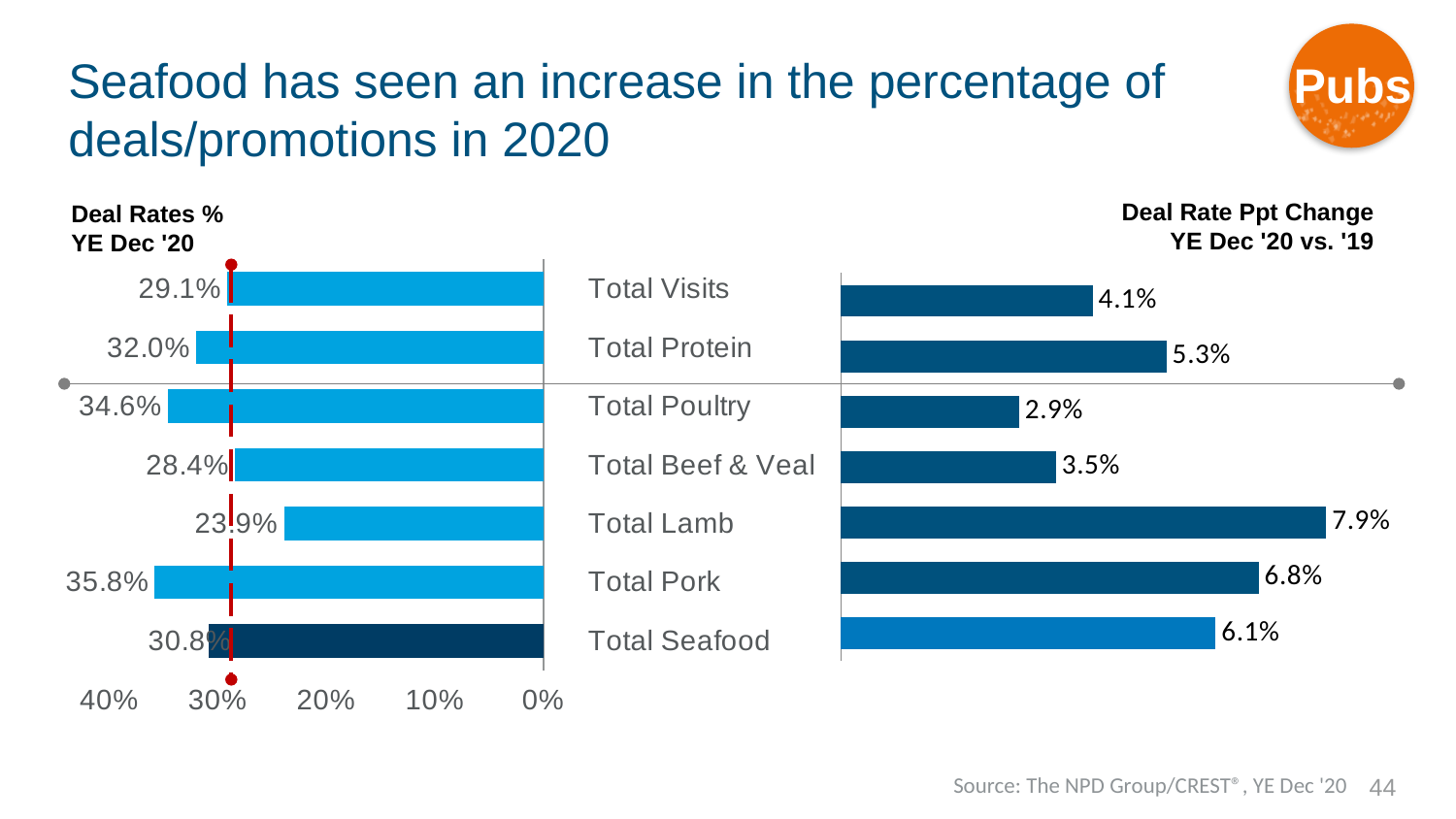
In the Deal Rate Ppt Change YE Dec '20 vs. '19 chart, which category has the lowest value? Total Poultry What type of chart is the Deal Rates % YE Dec '20 chart? Bar chart In the Deal Rate Ppt Change YE Dec '20 vs. '19 chart, what is the value for Total Pork? 6.8% In the Deal Rates % YE Dec '20 chart, what is the value for Total Seafood? 30.8% In the Deal Rates % YE Dec '20 chart, which category has the highest value? Total Pork In the Deal Rate Ppt Change YE Dec '20 vs. '19 chart, which category has the highest value? Total Lamb In the Deal Rate Ppt Change YE Dec '20 vs. '19 chart, what is the value for Total Poultry? 2.9% In the Deal Rates % YE Dec '20 chart, what is the value for Total Lamb? 23.9% How many categories are shown in the Deal Rate Ppt Change YE Dec '20 vs. '19 chart? 7 In the Deal Rate Ppt Change YE Dec '20 vs. '19 chart, what is the difference between Total Lamb and Total Seafood? 1.8% In the Deal Rates % YE Dec '20 chart, which category has the lowest value? Total Lamb In the Deal Rates % YE Dec '20 chart, which is larger, Total Poultry or Total Protein? Total Poultry